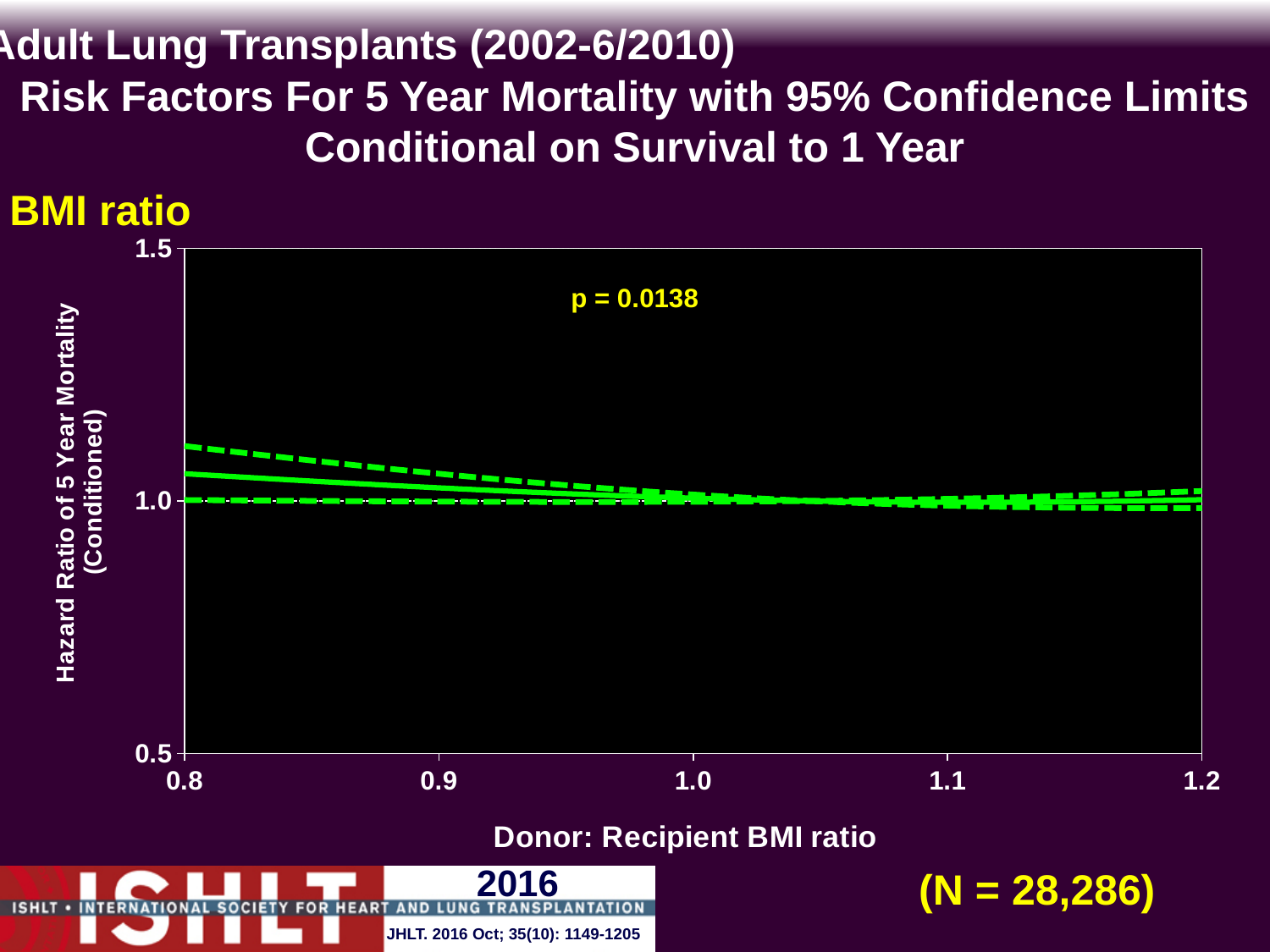
What is the label of the x axis? Donor: Recipient BMI ratio What kind of chart is shown on the slide? Line chart What is the label of the y axis? Hazard Ratio of 5 Year Mortality (Conditioned) What is the p-value printed on the chart? p = 0.0138 What is the sample size (N) shown on the slide? N = 28,286 How many lines are plotted on the chart? 3 What is the highest value shown on the y axis? 1.5 Does the solid hazard ratio line rise or fall as the Donor: Recipient BMI ratio increases from 0.8 to 1.2? Fall How many tick labels are shown on the x axis? 5 What is the lowest value shown on the x axis? 0.8 At a Donor: Recipient BMI ratio of 0.8, is the upper dashed confidence limit greater or less than 1.0? greater What is the highest value shown on the x axis? 1.2